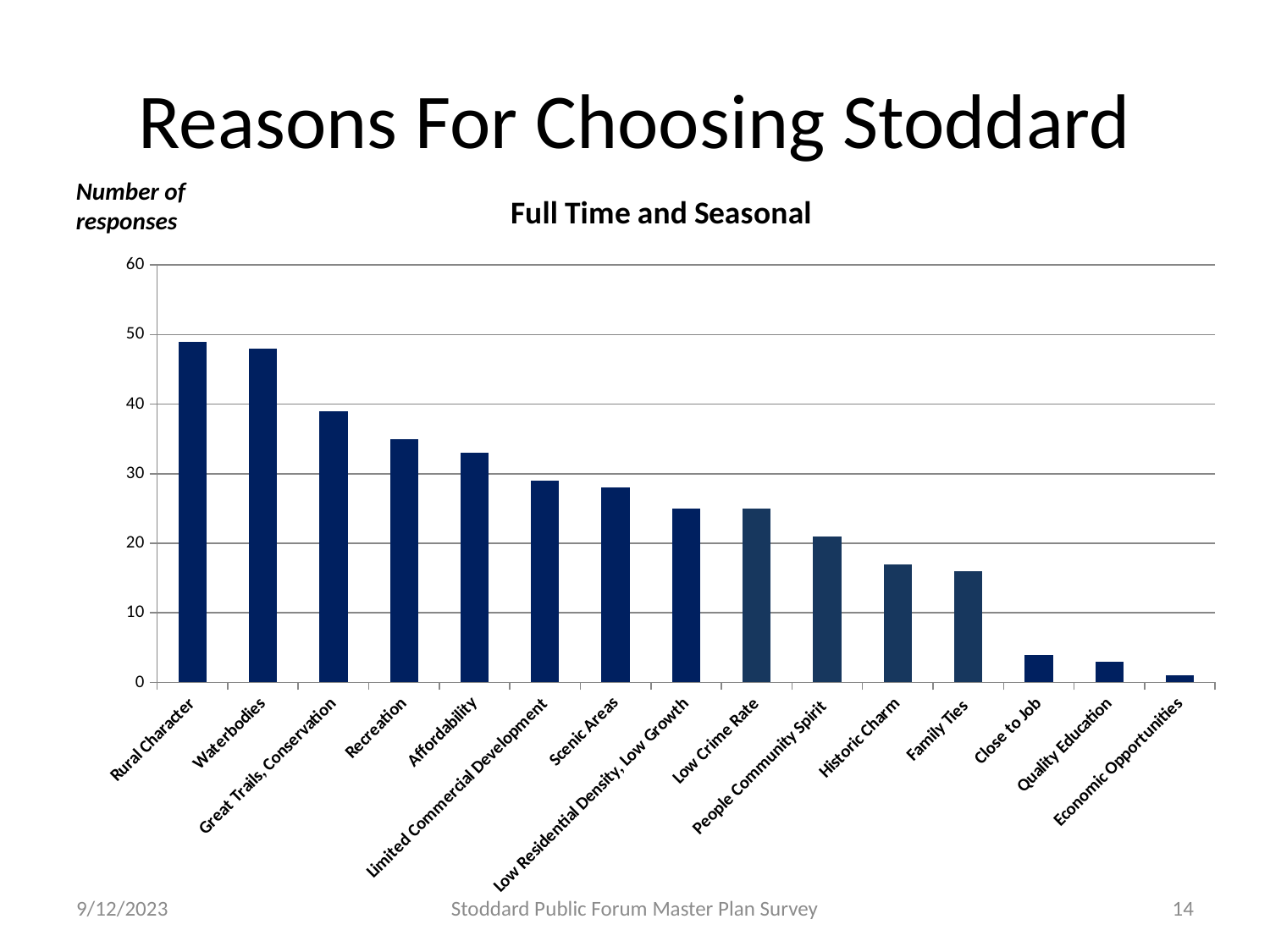
Is the value for Rural Character greater or less than 40? greater What kind of chart is shown on the slide? bar chart Which reason has the lowest number of responses? Economic Opportunities Is the value for Historic Charm greater or less than 20? less Which has more responses, Great Trails, Conservation or Recreation? Great Trails, Conservation What is the title shown above the chart? Full Time and Seasonal Which has more responses, Affordability or Scenic Areas? Affordability Do the values generally rise or fall moving from left to right along the x axis? fall Is the value for Recreation greater or less than 30? greater How many reasons (categories) are plotted on the chart? 15